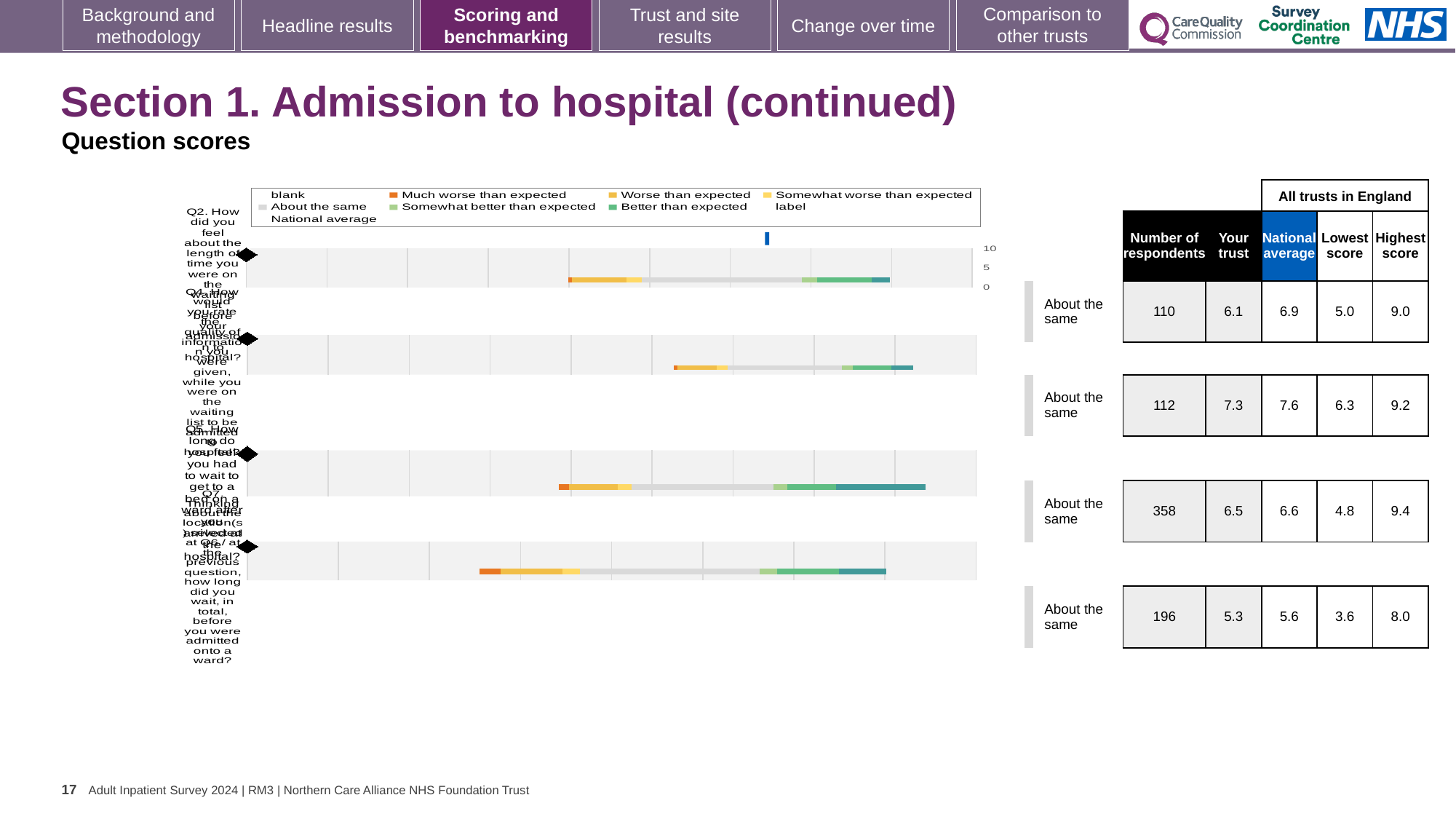
In the top row of the table, which is larger: 'Your trust' or 'National average'? National average What type of chart is shown on the slide? bar chart In the third row of the table, what is the difference between the 'Highest score' and the 'Lowest score'? 4.6 In the table, what is the 'National average' in the bottom row? 5.6 In the table, which row has the highest 'Number of respondents'? the third row (358) In the table, which row has the lowest 'Lowest score'? the bottom row (3.6) In the table, what is the 'Your trust' score in the top row? 6.1 In the top row of the table, what is the difference between the 'National average' and 'Your trust' score? 0.8 What benchmark rating is shown next to each of the four bars? About the same What is the heading above the 'National average', 'Lowest score' and 'Highest score' columns of the table? All trusts in England How many question bars are plotted in the chart? 4 In the table, what is the 'Number of respondents' in the second row? 112